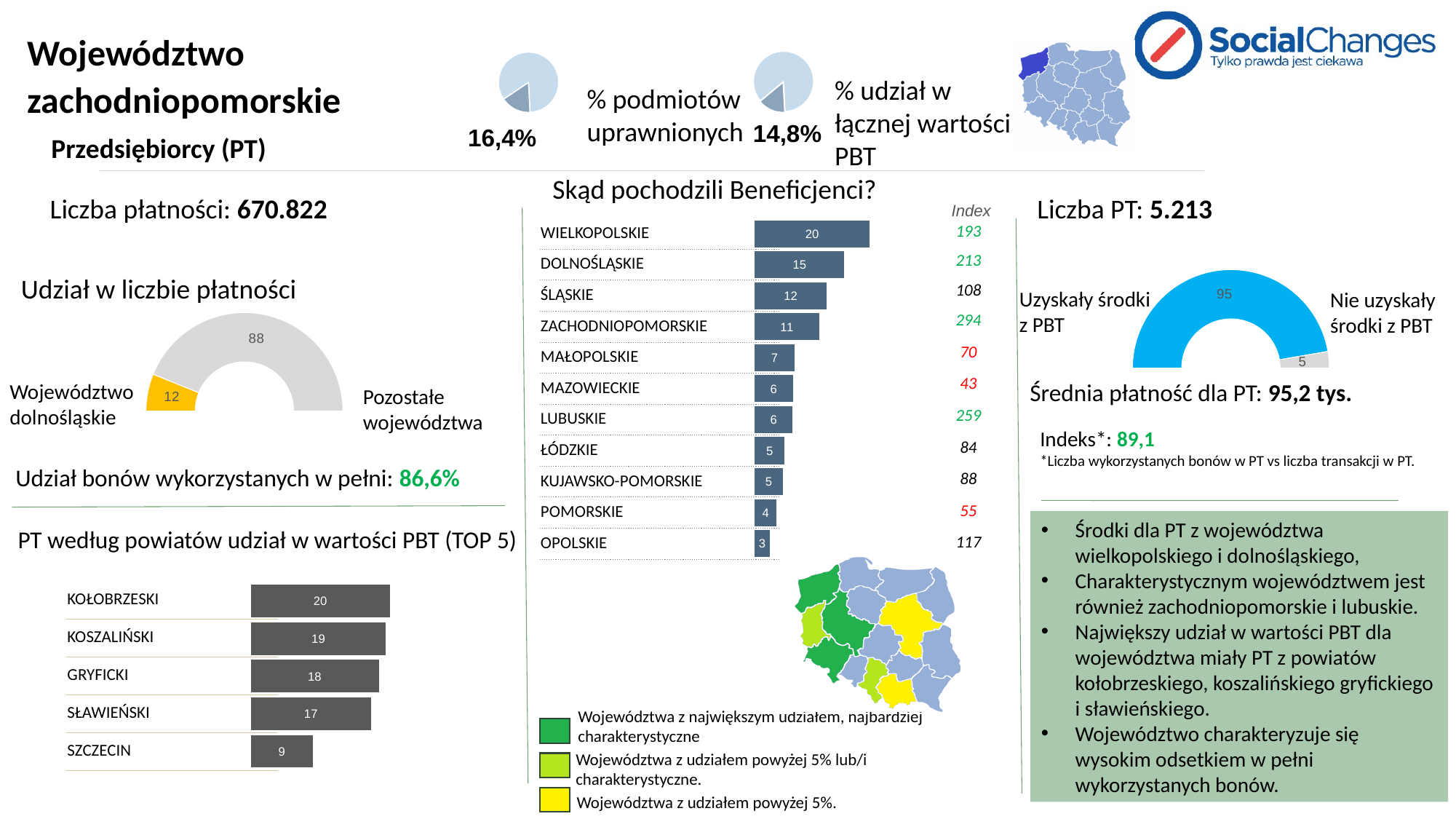
In the 'Skąd pochodzili Beneficjenci?' chart, what is the difference between the values for DOLNOŚLĄSKIE and ZACHODNIOPOMORSKIE? 4 In the 'Skąd pochodzili Beneficjenci?' chart, how many categories are shown? 11 In the 'PT według powiatów udział w wartości PBT (TOP 5)' chart, what is the value for GRYFICKI? 18 In the 'Skąd pochodzili Beneficjenci?' chart, what is the value for WIELKOPOLSKIE? 20 In the chart next to 'Liczba PT: 5.213', what is the value for 'Nie uzyskały środki z PBT'? 5 In the 'PT według powiatów udział w wartości PBT (TOP 5)' chart, which category has the lowest value? SZCZECIN In the 'Udział w liczbie płatności' chart, what is the value for 'Pozostałe województwa'? 88 In the 'PT według powiatów udział w wartości PBT (TOP 5)' chart, what is the difference between KOŁOBRZESKI and SZCZECIN? 11 In the 'Skąd pochodzili Beneficjenci?' chart, which category has the lowest value? OPOLSKIE In the 'Skąd pochodzili Beneficjenci?' chart, which category has the highest value? WIELKOPOLSKIE What kind of chart is 'PT według powiatów udział w wartości PBT (TOP 5)'? bar chart In the 'Skąd pochodzili Beneficjenci?' chart, what is the Index value shown for ZACHODNIOPOMORSKIE? 294